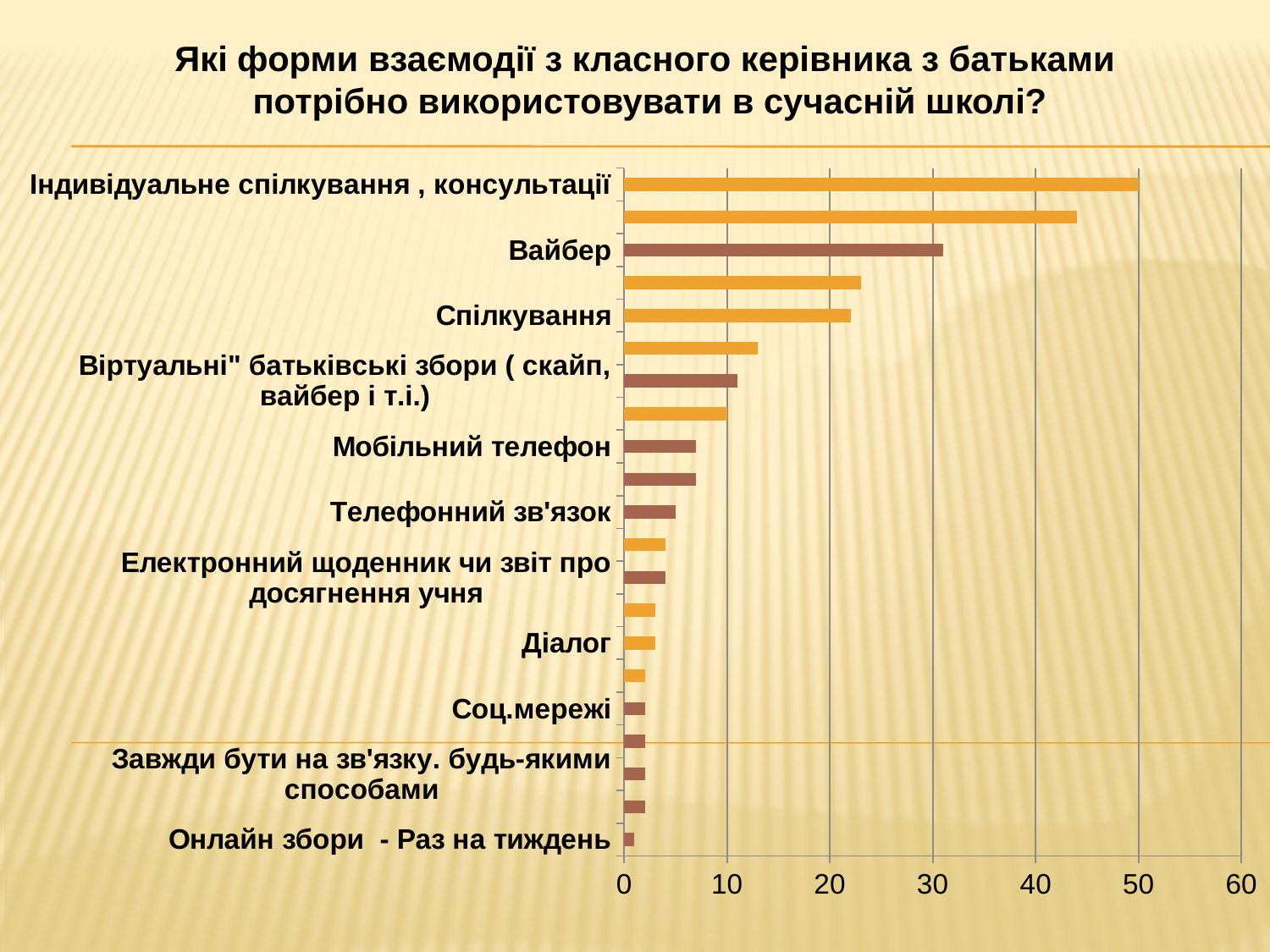
Is the value for Мобільний телефон greater or less than 10? less Is the value for Індивідуальне спілкування , консультації greater or less than 40? greater What is the title of the slide above the chart? Які форми взаємодії з класного керівника з батьками потрібно використовувати в сучасній школі? Do the bar values increase or decrease going from the top of the chart to the bottom? decrease Which has a larger value, Мобільний телефон or Діалог? Мобільний телефон Which has a larger value, Вайбер or Спілкування? Вайбер Which labeled category has the longest bar? Індивідуальне спілкування , консультації Is the value for Спілкування greater or less than 30? less What is the highest value shown on the horizontal axis? 60 Which labeled category has the shortest bar? Онлайн збори - Раз на тиждень What kind of chart is shown on the slide? bar chart